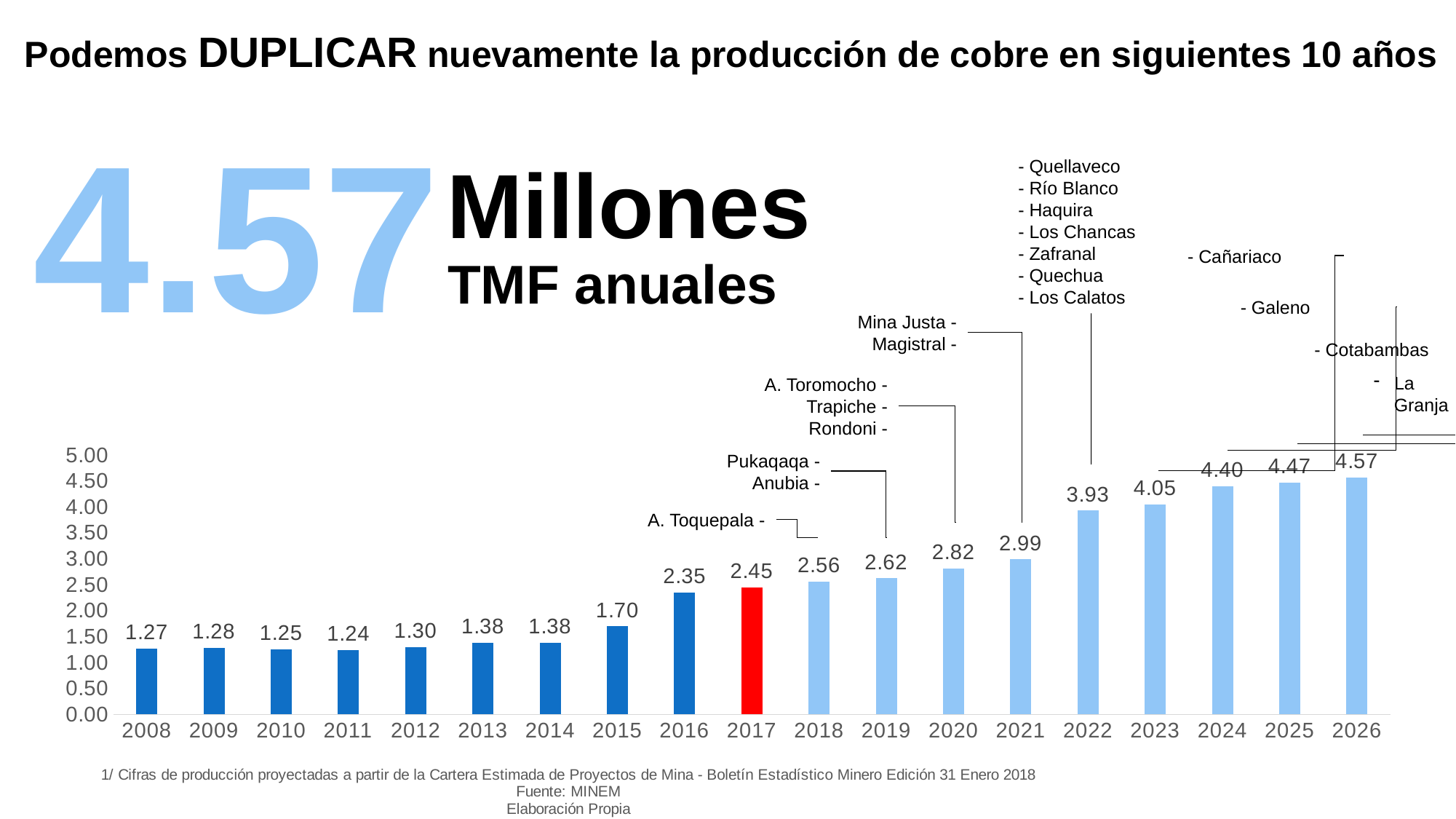
Which is larger, the value for 2015 or the value for 2014? 2015 Which year has the lowest value? 2011 Which year has the highest value? 2026 What kind of chart is shown on the slide? bar chart What is the value shown for 2022? 3.93 How many years are shown on the x axis? 19 What is the difference between the values for 2021 and 2020? 0.17 What is the value shown for 2011? 1.24 What is the value shown for 2017? 2.45 Which year's bar is coloured red? 2017 What is the difference between the values for 2026 and 2016? 2.22 Do the values generally rise or fall from 2016 to 2026? rise